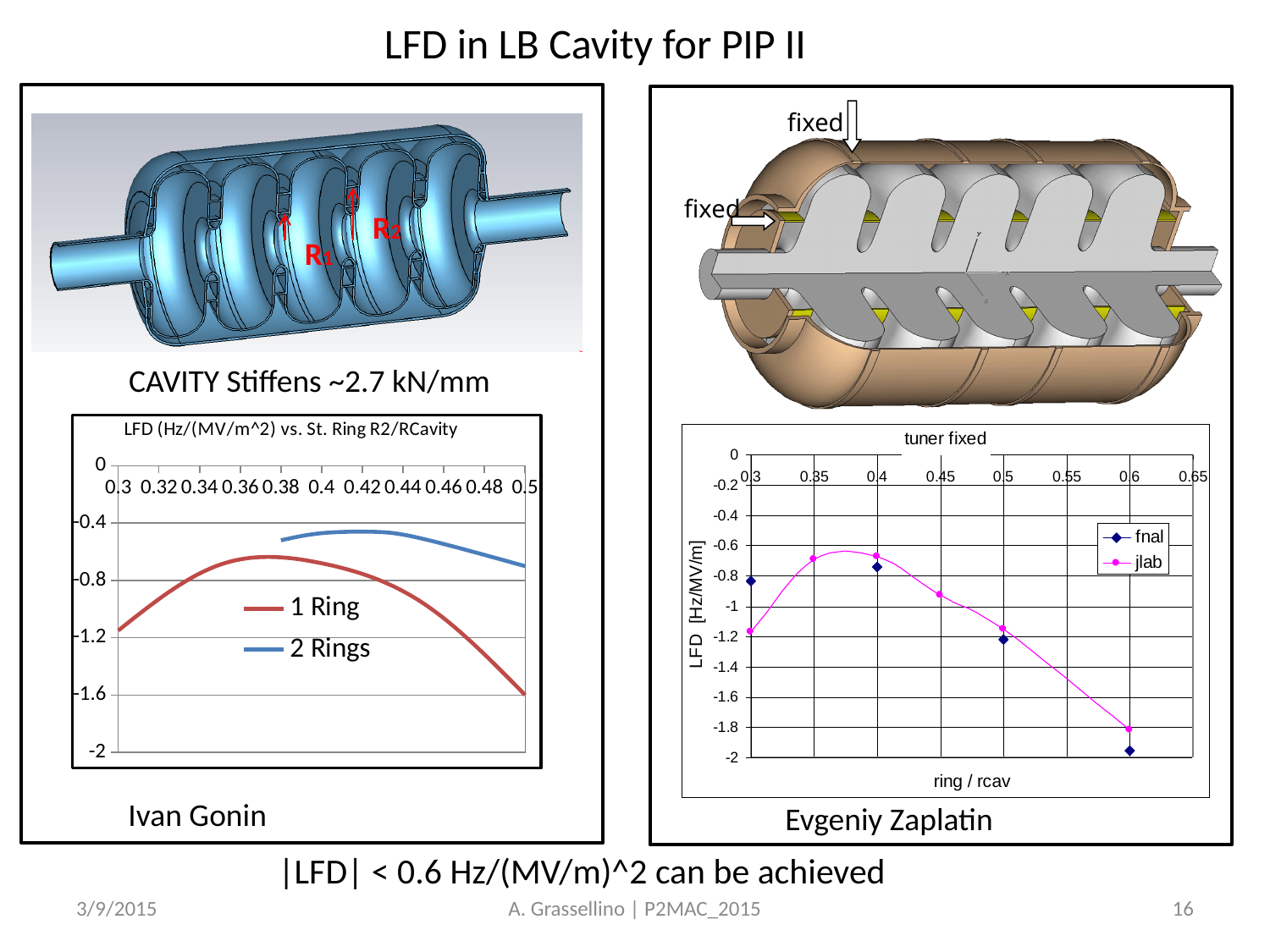
In the left chart (LFD vs. St. Ring R2/RCavity), which series has the higher value at x = 0.5, 1 Ring or 2 Rings? 2 Rings In the right chart titled "tuner fixed", is the fnal value at ring / rcav = 0.6 greater or less than -1.8? less In the left chart (LFD vs. St. Ring R2/RCavity), is the value of the 2 Rings series at x = 0.5 greater or less than -0.8? greater In the right chart titled "tuner fixed", how many data points does the fnal series have? 4 What are the two legend entries in the left chart (LFD vs. St. Ring R2/RCavity)? 1 Ring, 2 Rings How many series does the legend of the right chart titled "tuner fixed" list? 2 In the left chart (LFD vs. St. Ring R2/RCavity), does the 1 Ring series rise or fall between x = 0.4 and x = 0.5? fall How many series does the legend of the left chart (LFD vs. St. Ring R2/RCavity) list? 2 In the right chart titled "tuner fixed", which series has the higher value at ring / rcav = 0.3, fnal or jlab? fnal What kind of chart is the left chart titled "LFD (Hz/(MV/m^2) vs. St. Ring R2/RCavity"? line chart In the left chart (LFD vs. St. Ring R2/RCavity), is the value of the 1 Ring series at x = 0.5 greater or less than -1.2? less What is the x-axis title of the right chart titled "tuner fixed"? ring / rcav